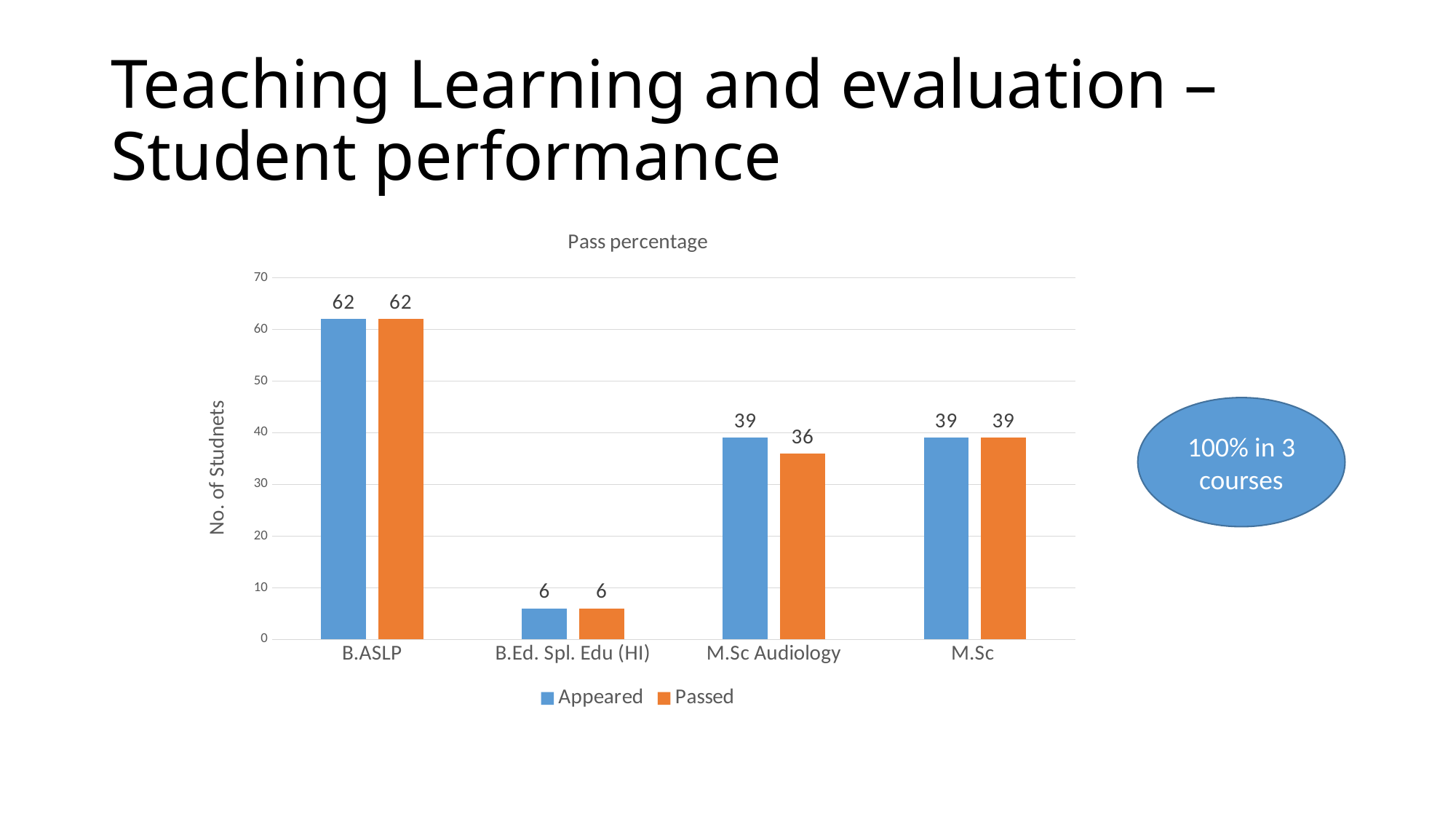
What is the title of the chart? Pass percentage How many series does the legend list? 2 Which course has the highest number of students appeared? B.ASLP What is the difference between the number appeared and the number passed for M.Sc Audiology? 3 How many courses are shown on the x axis of the chart? 4 What kind of chart is shown on the slide? Bar chart How many students passed in M.Sc Audiology? 36 What is the number of students who appeared for B.ASLP? 62 Which course has the lowest number of students passed? B.Ed. Spl. Edu (HI) How many students appeared for B.Ed. Spl. Edu (HI)? 6 What is the label of the vertical axis? No. of Studnets Which is larger for M.Sc Audiology: the number appeared or the number passed? Appeared